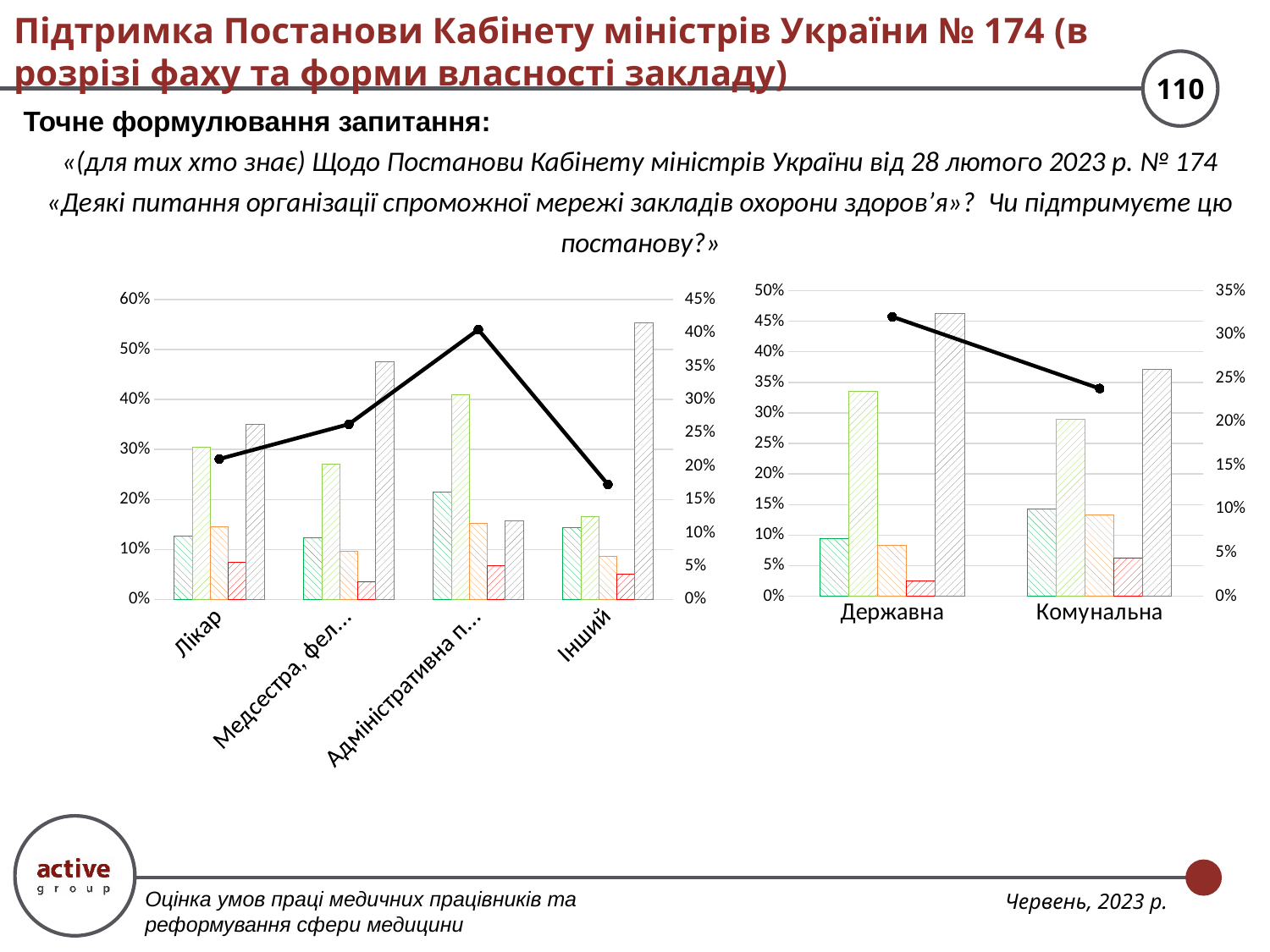
In the right chart, is the black line value for Державна (right axis) greater or less than 30%? greater In the right chart, which category has the higher value on the black line, Державна or Комунальна? Державна In the left chart, is the black line value for Інший (right axis) greater or less than 20%? less What kind of chart is the right chart? Combined bar and line chart How many categories are shown on the x axis of the left chart? 4 In the left chart, is the tallest (grey hatched) bar for Інший greater or less than 50% on the left axis? greater How many categories are shown on the x axis of the right chart? 2 How many bars are drawn for each category in the right chart? 5 In the right chart, does the black line rise or fall from Державна to Комунальна? Falls